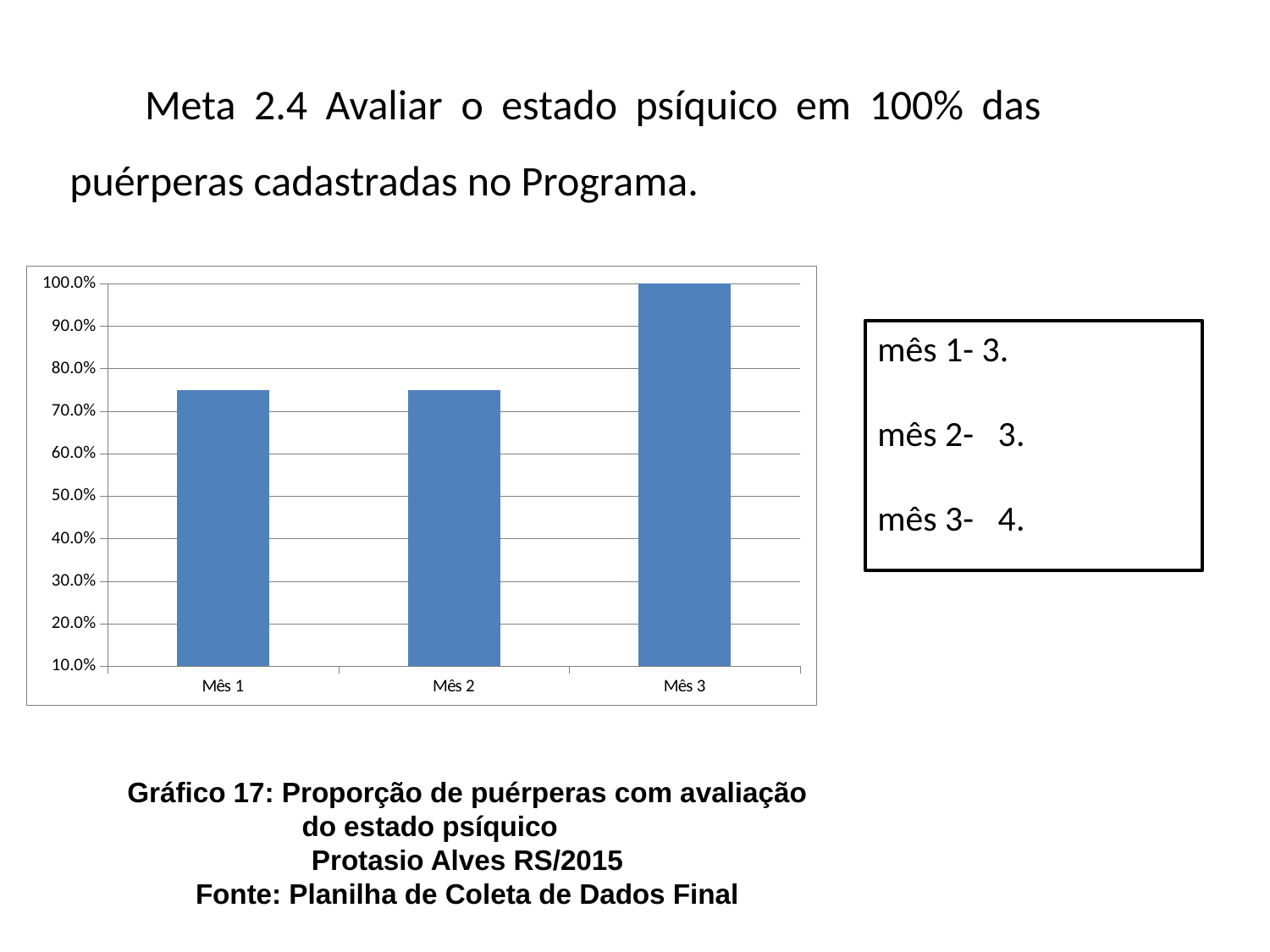
Is the value for Mês 2 greater or less than 80%? less What is the value for Mês 3? 100.0% How many months are shown on the x axis? 3 What is the number of the chart given in the caption below it? Gráfico 17 Is the value for Mês 1 greater or less than 80%? less Which is larger, the value for Mês 1 or the value for Mês 3? Mês 3 Does the value rise or fall from Mês 2 to Mês 3? rise What is the highest value shown on the y axis? 100.0% Is the value for Mês 2 greater or less than 60%? greater What kind of chart is shown on the slide? bar chart Which month has the highest value? Mês 3